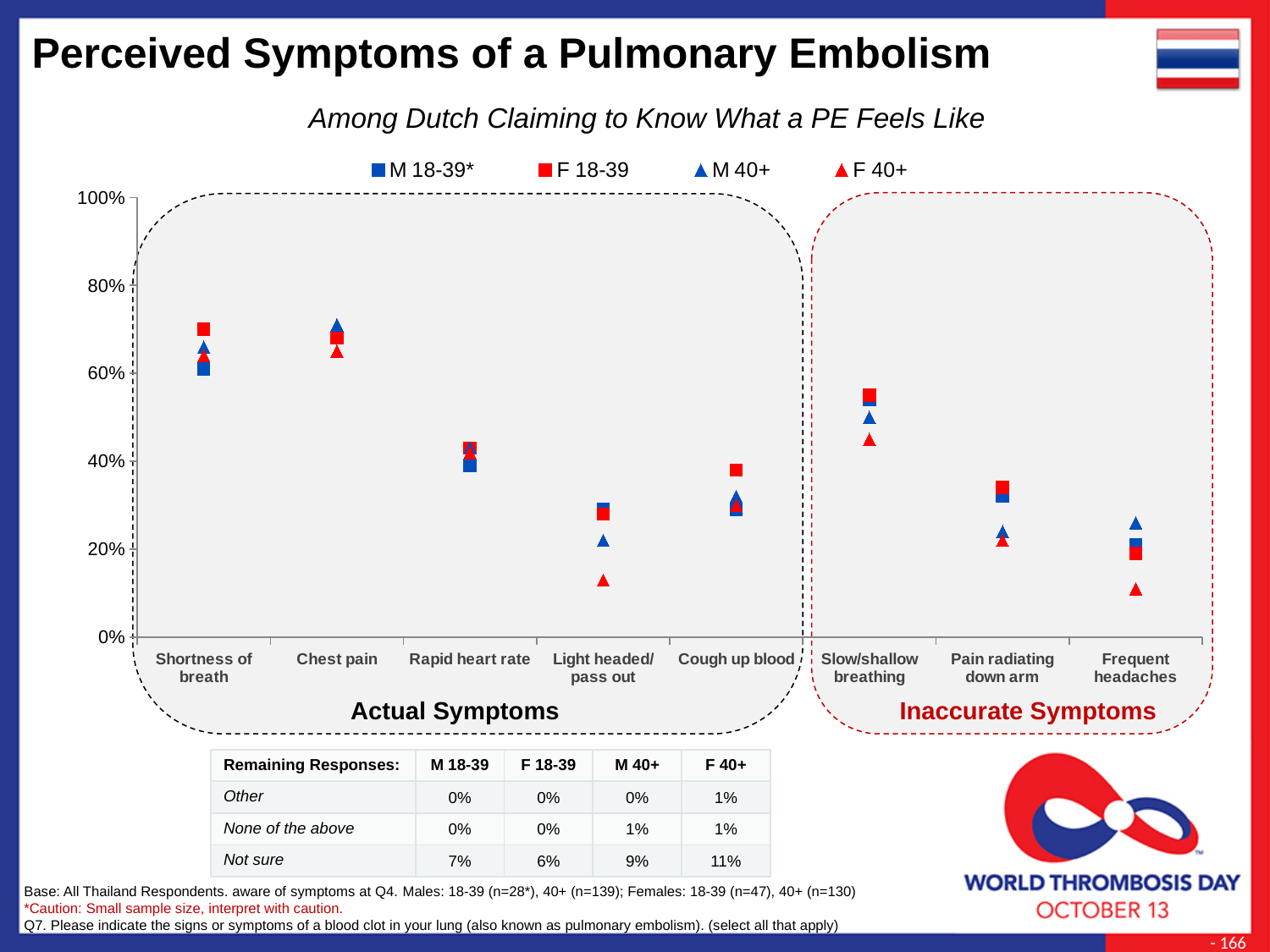
Which symptom has the lowest value for the M 18-39 series? Frequent headaches How many symptom categories are plotted along the x axis? 8 At Light headed/pass out, which is larger: the value for M 18-39 or for F 40+? M 18-39 Is the value for M 18-39 at Cough up blood greater or less than 40%? less Which symptoms are grouped under the 'Inaccurate Symptoms' label? Slow/shallow breathing, Pain radiating down arm, Frequent headaches Is the value for F 40+ at Frequent headaches greater or less than 20%? less Is the value for F 18-39 at Shortness of breath greater or less than 60%? greater Which symptom has the highest value for the M 40+ series? Chest pain What kind of chart is shown on the slide? scatter chart How many series does the chart legend list? 4